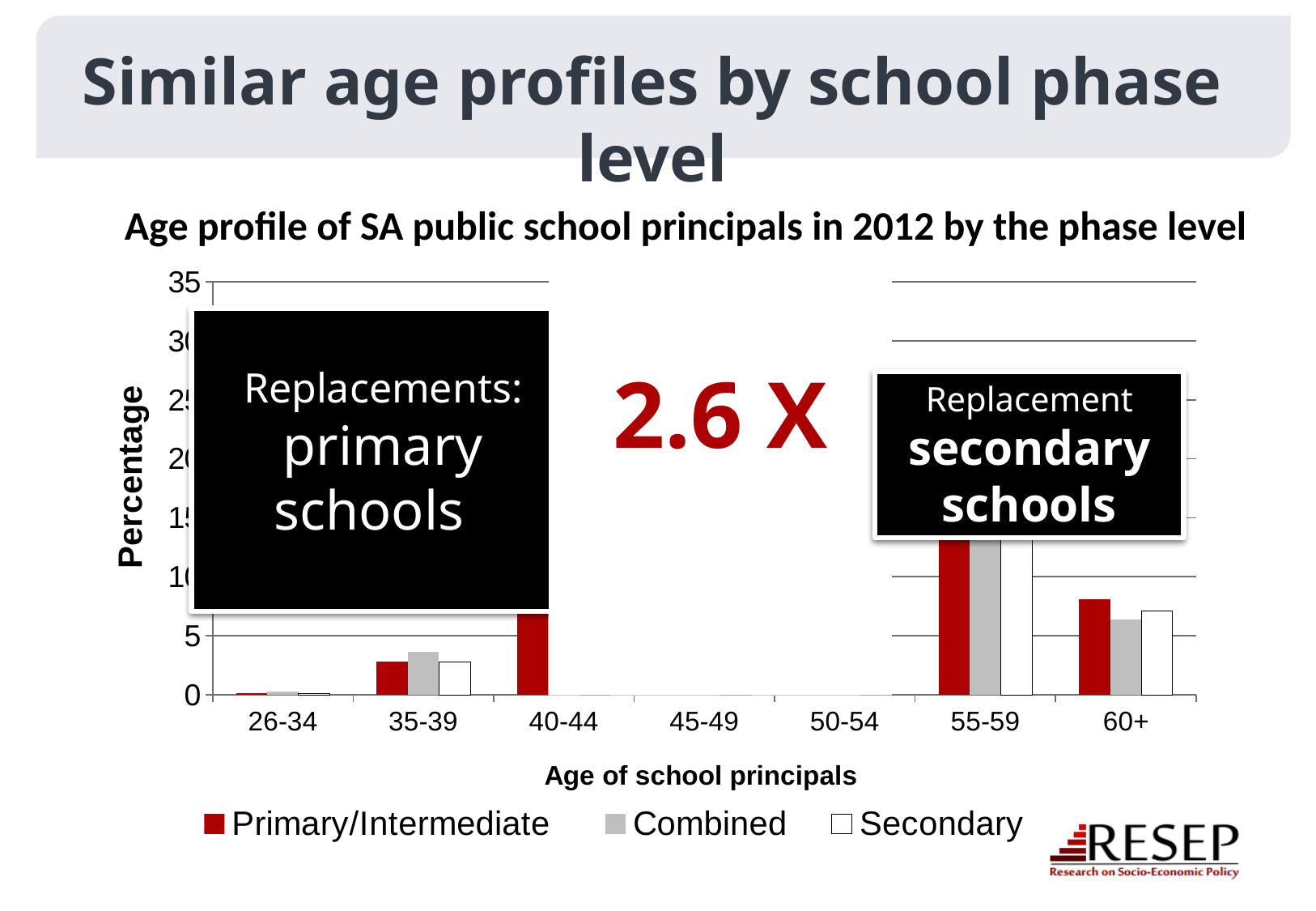
What is the title of the chart? Age profile of SA public school principals in 2012 by the phase level Is the value for Primary/Intermediate in the 35-39 age group greater or less than 5? less Is the value for Primary/Intermediate in the 60+ age group greater or less than 10? less How many age categories are shown on the x axis of the chart? 7 What kind of chart is shown on the slide? bar chart Is the value for Secondary in the 26-34 age group greater or less than 5? less How many series does the chart's legend list? 3 For the Primary/Intermediate series, which age group has the larger value: 55-59 or 60+? 55-59 What is the label on the vertical axis of the chart? Percentage In the 60+ age group, which is larger: the Primary/Intermediate value or the Combined value? Primary/Intermediate